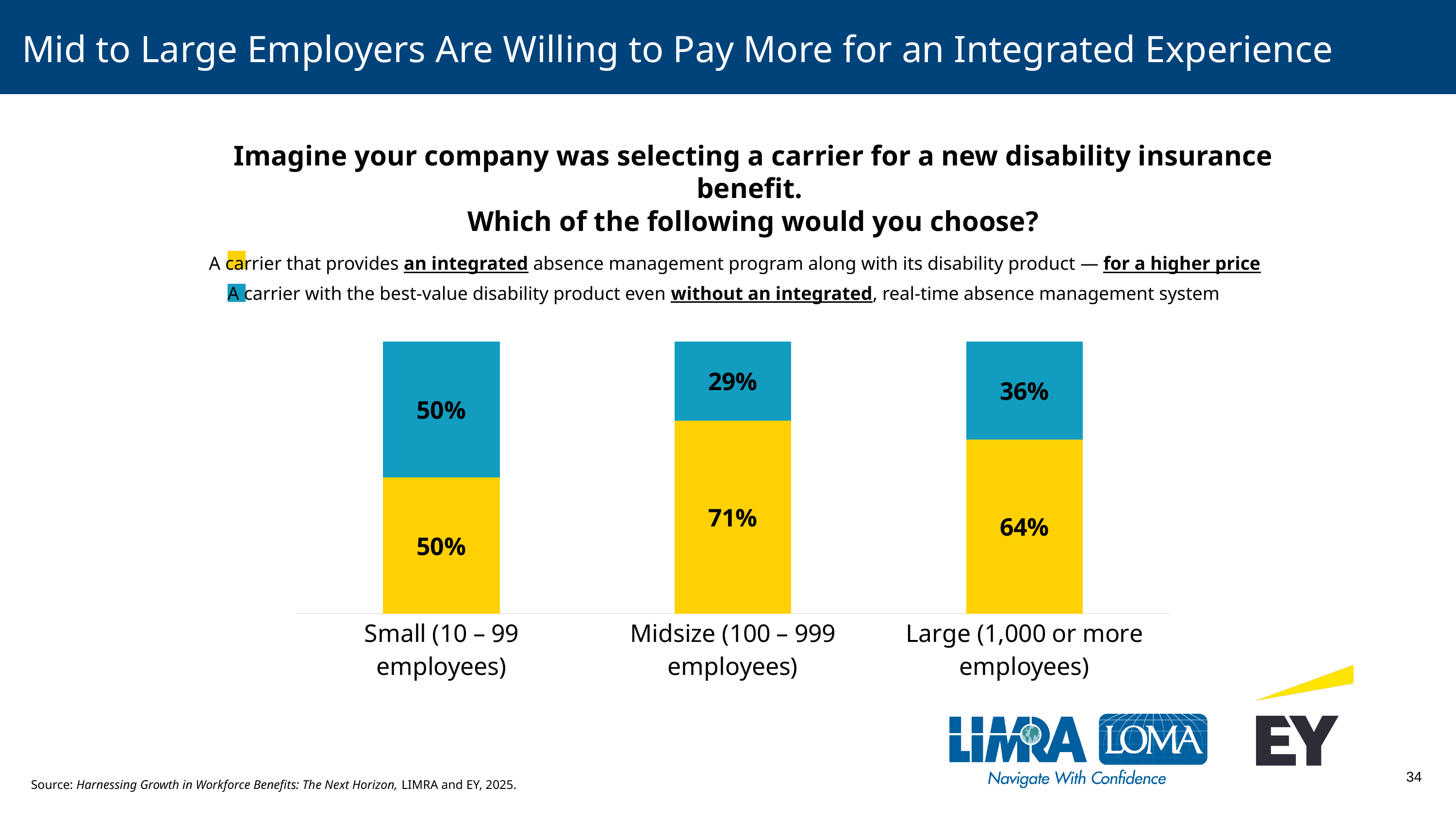
Which employer size group has the lowest share choosing the best-value disability product without an integrated system? Midsize (100 – 999 employees) How many employer size categories are shown on the x axis of the chart? 3 What percentage of midsize employers (100 – 999 employees) would choose a carrier that provides an integrated absence management program for a higher price? 71% What type of chart is shown on the slide? Stacked bar chart What percentage of small employers (10 – 99 employees) would choose the carrier with an integrated absence management program for a higher price? 50% What is the difference in percentage points between midsize and large employers choosing the integrated program for a higher price? 7 Which colour represents the carrier that provides an integrated absence management program for a higher price? Yellow What is the total of the two segments in the bar for large employers (1,000 or more employees)? 100% What percentage of large employers (1,000 or more employees) would choose a carrier with the best-value disability product even without an integrated absence management system? 36% Which employer size group has the highest share choosing the integrated absence management program for a higher price? Midsize (100 – 999 employees) Which group has a larger share choosing the best-value product without an integrated system: small employers or large employers? Small (10 – 99 employees) How many response options (series) are shown in the chart's legend? 2